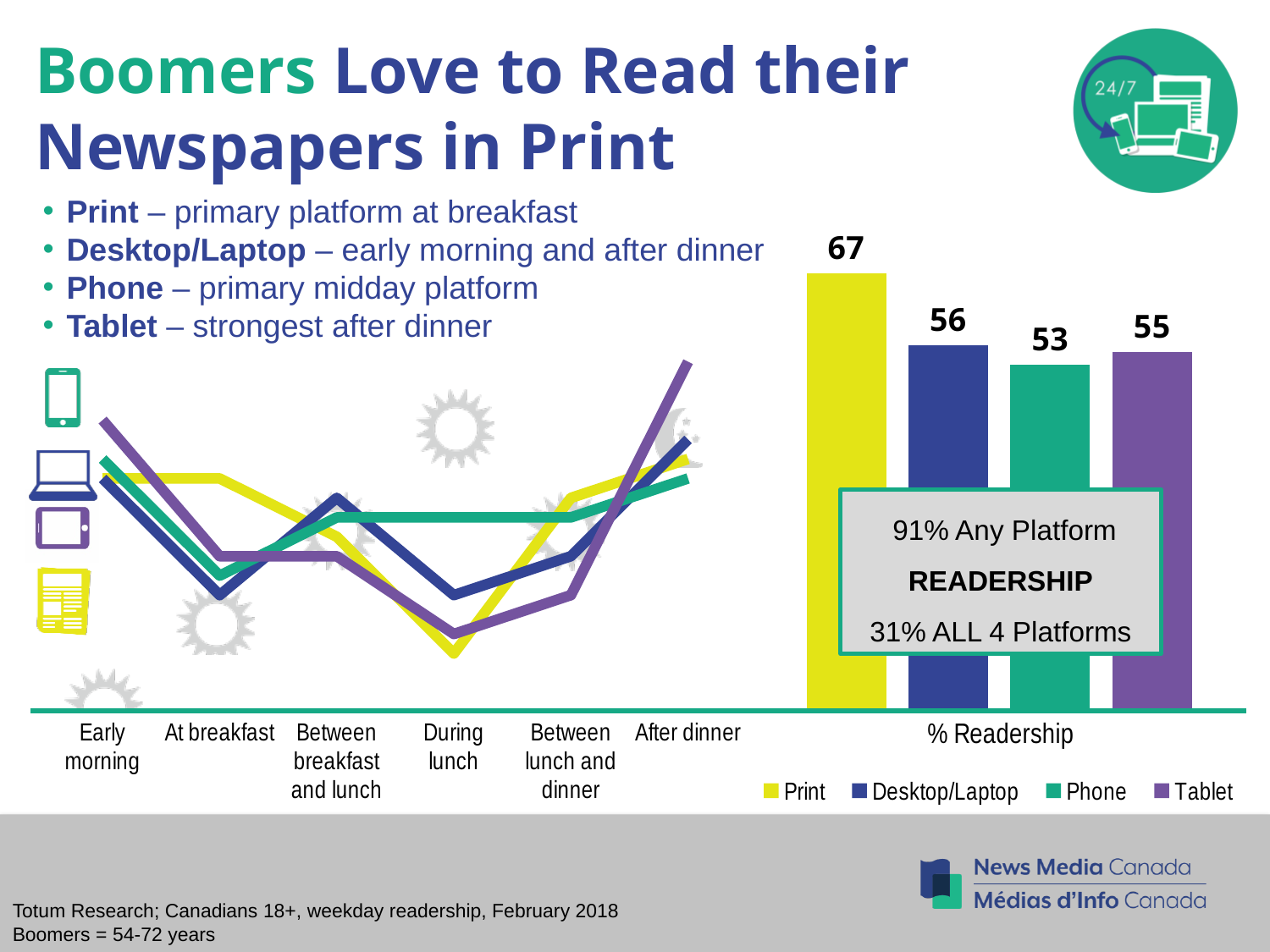
How many series does the legend list? 4 In the bar chart on the right, what is the % Readership value for Print? 67 In the line chart on the left, which platform has the highest line at After dinner? Tablet In the bar chart on the right, how many bars are plotted? 4 In the line chart on the left, how many time-of-day categories are shown on the x axis? 6 In the bar chart on the right, what is the % Readership value for Tablet? 55 In the bar chart on the right, which platform has the highest % Readership? Print In the bar chart on the right, what is the difference between the Print and Desktop/Laptop values? 11 What kind of chart is the chart on the left? Line chart In the bar chart on the right, which platform has the lowest % Readership? Phone In the bar chart on the right, which is larger: the value for Desktop/Laptop or the value for Tablet? Desktop/Laptop In the bar chart on the right, what is the % Readership value for Phone? 53